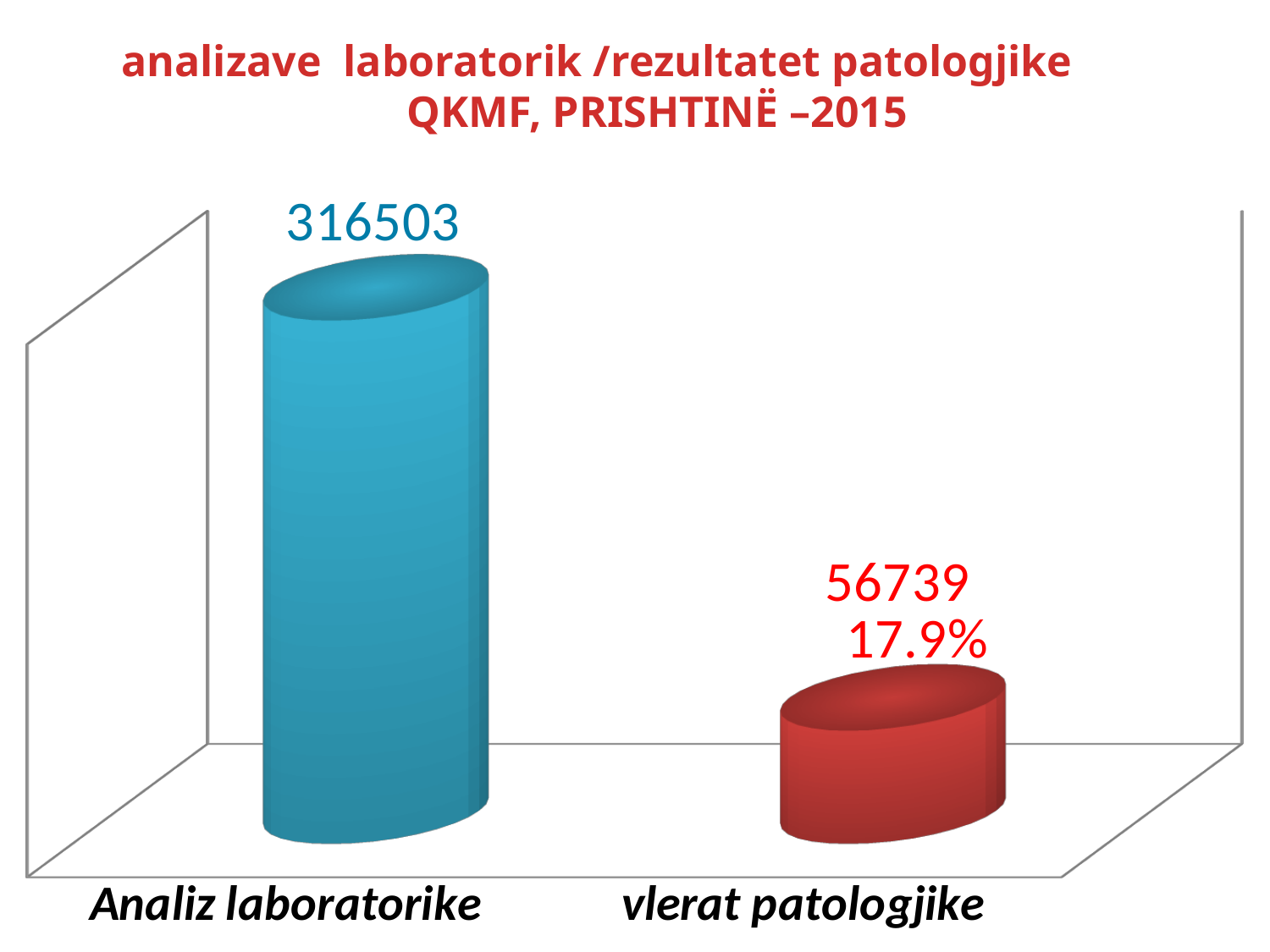
What kind of chart is shown on the slide? bar chart How many categories are shown in the chart? 2 What is the value for vlerat patologjike? 56739 What colour is the bar for Analiz laboratorike? blue What is the difference between the values for Analiz laboratorike and vlerat patologjike? 259764 Which is larger, the value for Analiz laboratorike or the value for vlerat patologjike? Analiz laboratorike Which category has the lowest value? vlerat patologjike Which category has the highest value? Analiz laboratorike What is the value for Analiz laboratorike? 316503 What colour is the bar for vlerat patologjike? red What percentage is shown above the vlerat patologjike bar? 17.9%